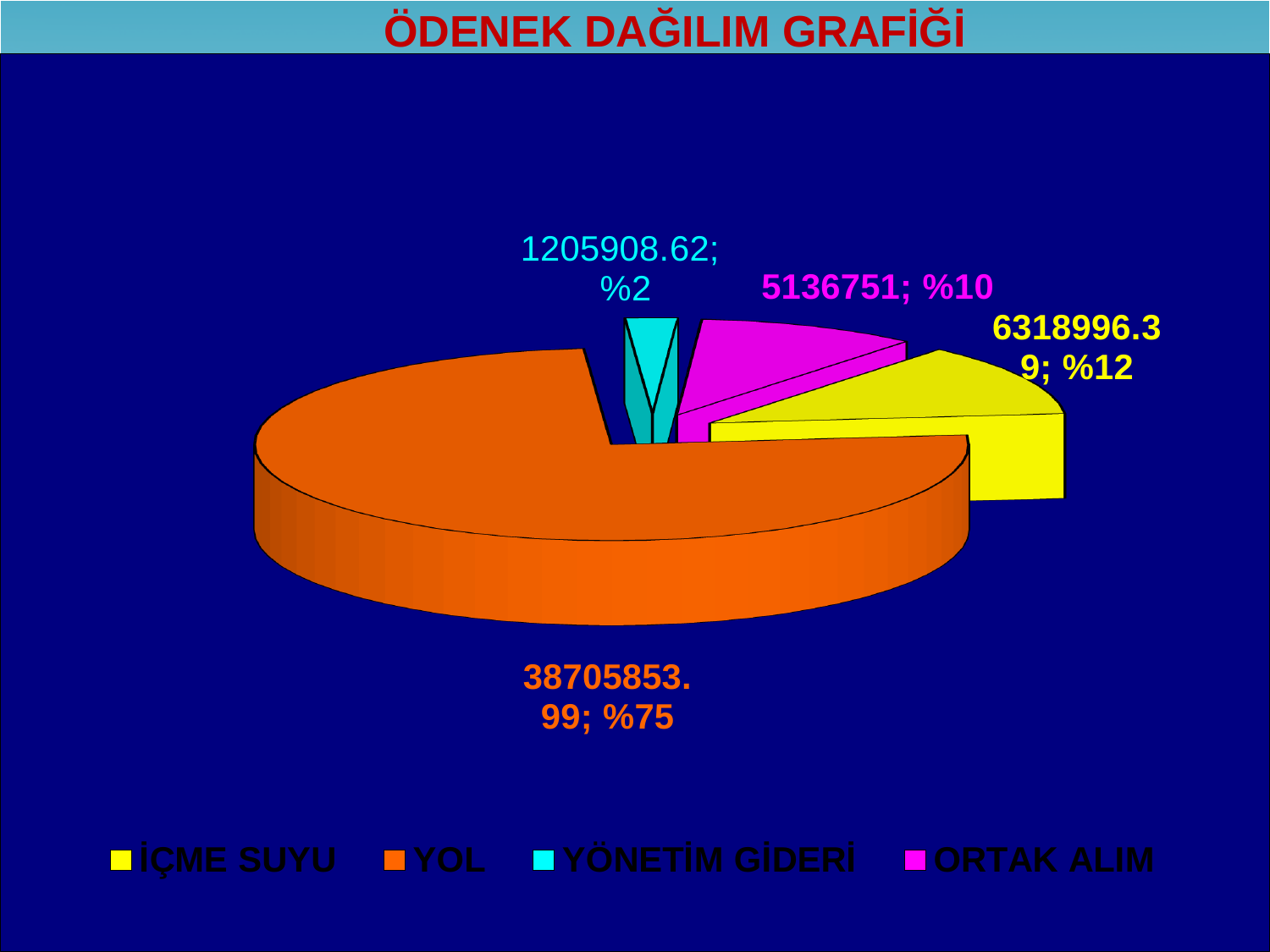
Which category has the largest slice? YOL What is the title of the chart? ÖDENEK DAĞILIM GRAFİĞİ What is the value for ORTAK ALIM? 5136751 What is the value for YOL? 38705853.99 What is the value for İÇME SUYU? 6318996.39 What share of the pie does YOL represent? %75 What share of the pie does ORTAK ALIM represent? %10 What is the value for YÖNETİM GİDERİ? 1205908.62 What kind of chart is shown on the slide? pie chart Which category has the smallest slice? YÖNETİM GİDERİ How many entries does the legend list? 4 How many slices does the pie chart have? 4